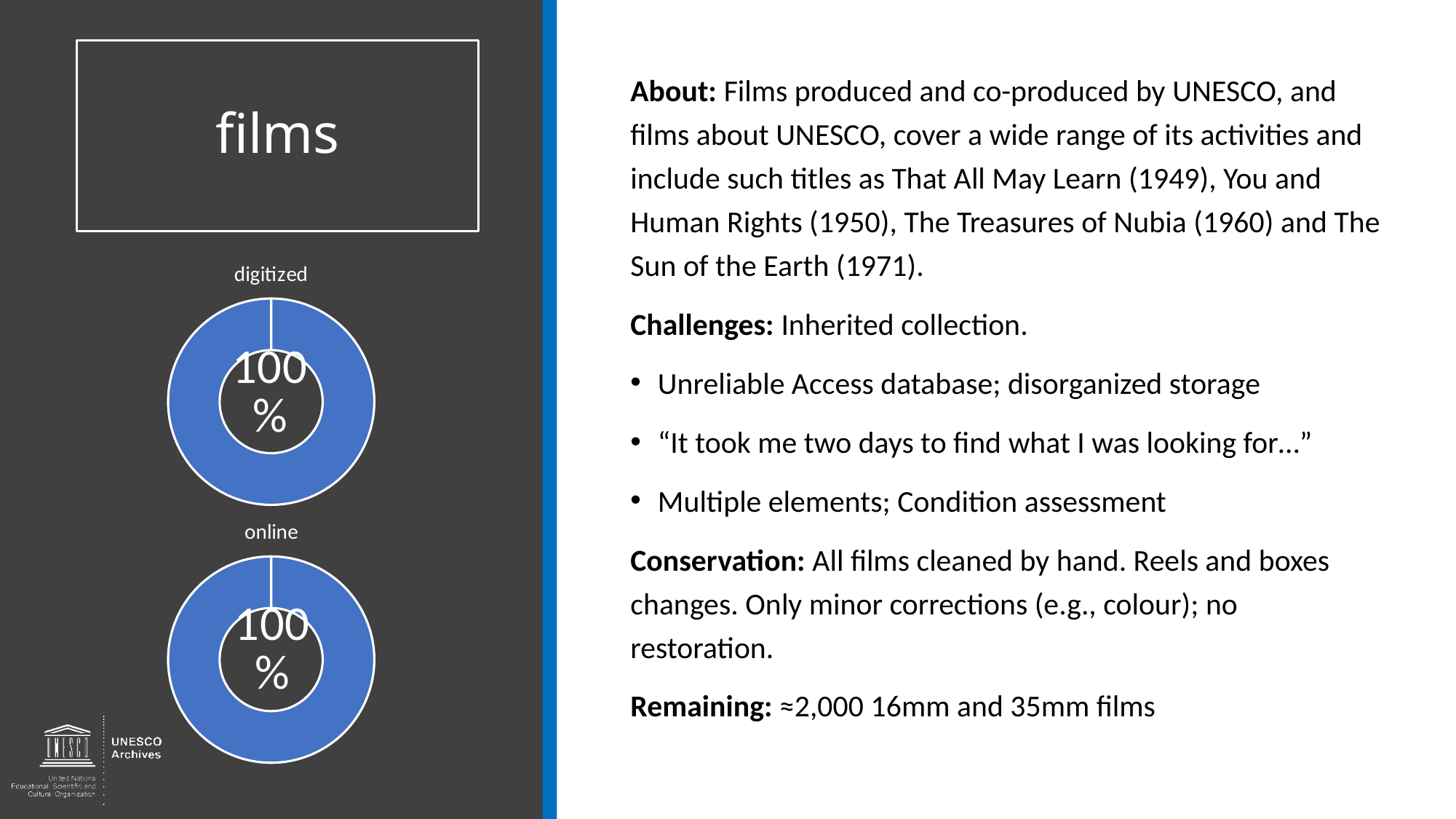
What is the title of the lower doughnut chart? online Is the value shown on the 'digitized' chart greater or less than 50%? greater On the 'online' chart, what percentage is shown in the centre? 100% How many doughnut charts are shown on the slide? 2 What kind of chart is the 'online' chart? Doughnut chart On the 'digitized' chart, what percentage is shown in the centre? 100% What is the difference between the percentage on the 'digitized' chart and the percentage on the 'online' chart? 0% Is the value shown on the 'online' chart greater or less than 50%? greater What is the title of the upper doughnut chart? digitized What kind of chart is the 'digitized' chart? Doughnut chart